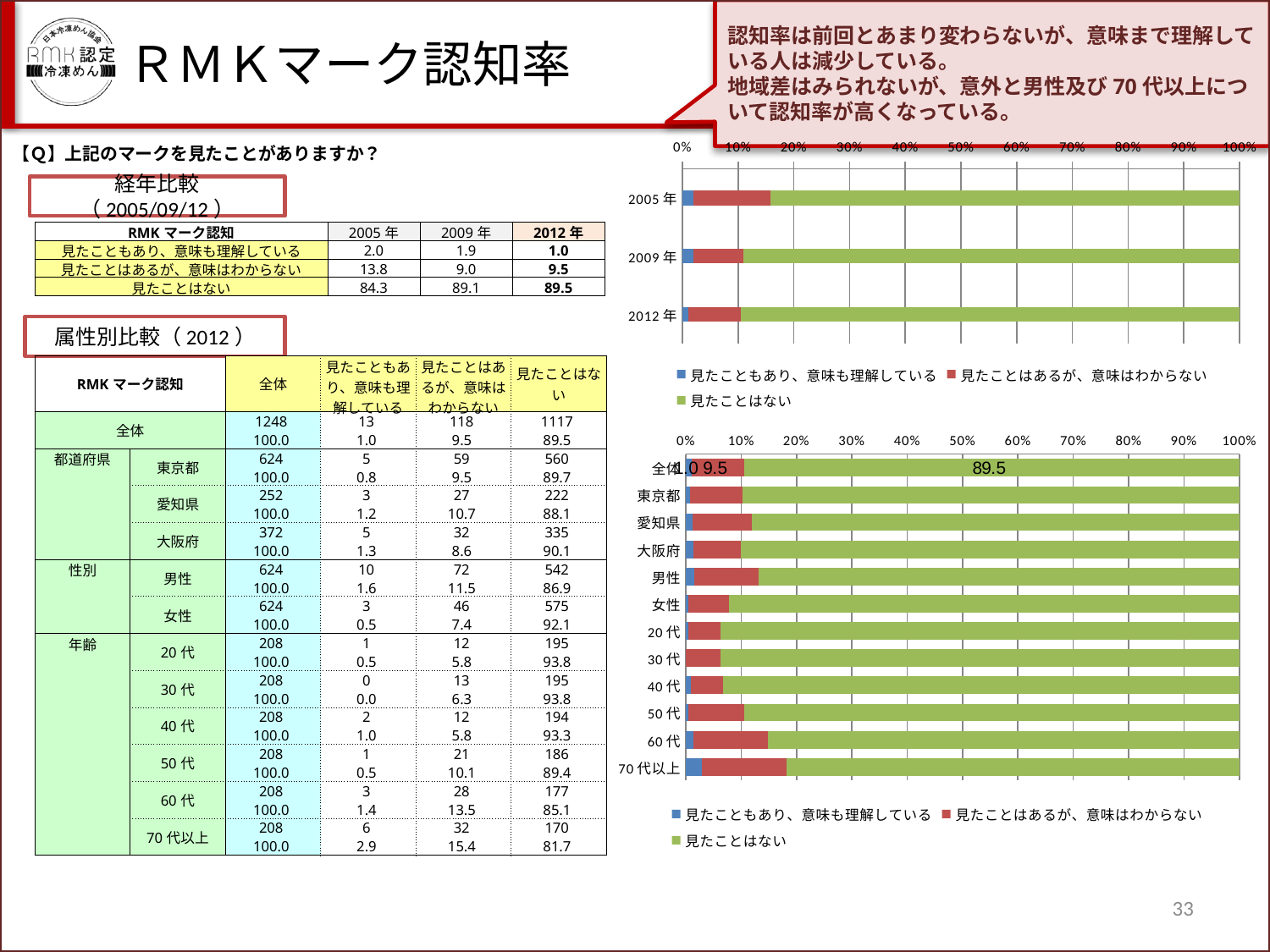
In the bottom chart on the right (属性別比較), what is the data label for 見たことはあるが、意味はわからない on the 全体 bar? 9.5 In the top chart on the right, which year has the longer 見たことはあるが、意味はわからない (red) segment, 2005年 or 2012年? 2005年 What kind of chart is the top chart on the right (the one with 2005年, 2009年, 2012年)? bar chart In the top chart on the right, how many year categories are plotted? 3 In the bottom chart on the right (属性別比較), is the 見たことはない segment for 70代以上 greater or less than 90%? less In the bottom chart on the right (属性別比較), how many categories are plotted on the vertical axis? 12 In the bottom chart on the right (属性別比較), what colour represents 見たことはない in the legend? green In the top chart on the right, is the 見たことはない segment for 2005年 greater or less than 80%? greater In the bottom chart on the right (属性別比較), which category has the longest 見たことはあるが、意味はわからない (red) segment? 70代以上 In the bottom chart on the right (属性別比較), what is the total of the three labelled segments on the 全体 bar? 100.0 In the top chart on the right, how many series does the legend list? 3 In the bottom chart on the right (属性別比較), what is the data label for 見たことはない on the 全体 bar? 89.5